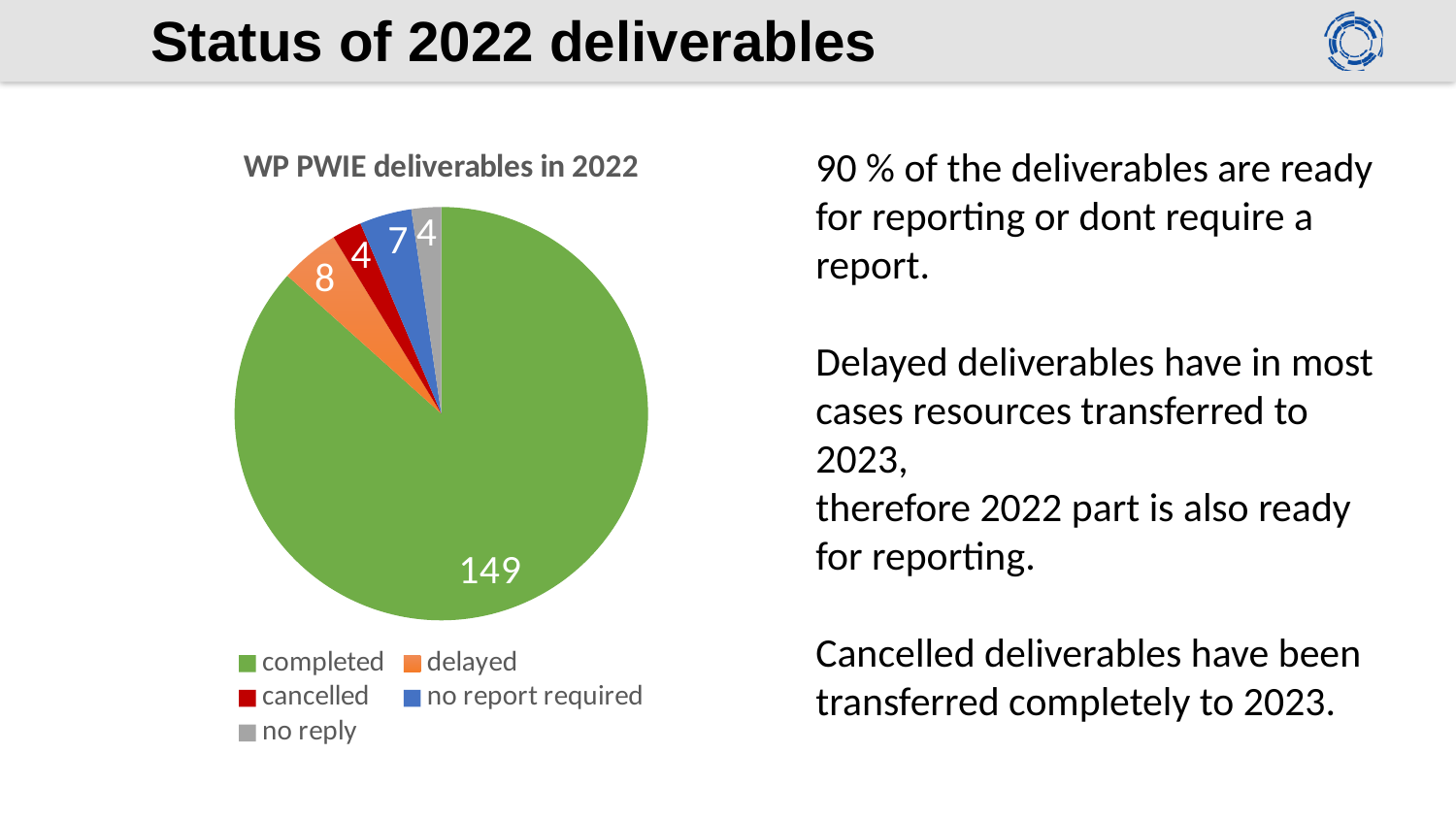
What type of chart is shown on the slide? pie chart What is the value shown for the no report required slice? 7 What is the difference between the completed and delayed values? 141 Which is larger, the delayed slice or the no report required slice? delayed Which category has the largest slice in the pie chart? completed What is the title of the chart? WP PWIE deliverables in 2022 What is the total of all the slices in the pie chart? 172 How many deliverables are labelled as completed in the pie chart? 149 What is the value shown for the delayed slice? 8 What is the value shown for the cancelled slice? 4 How many categories does the legend list? 5 What colour is the completed slice? green